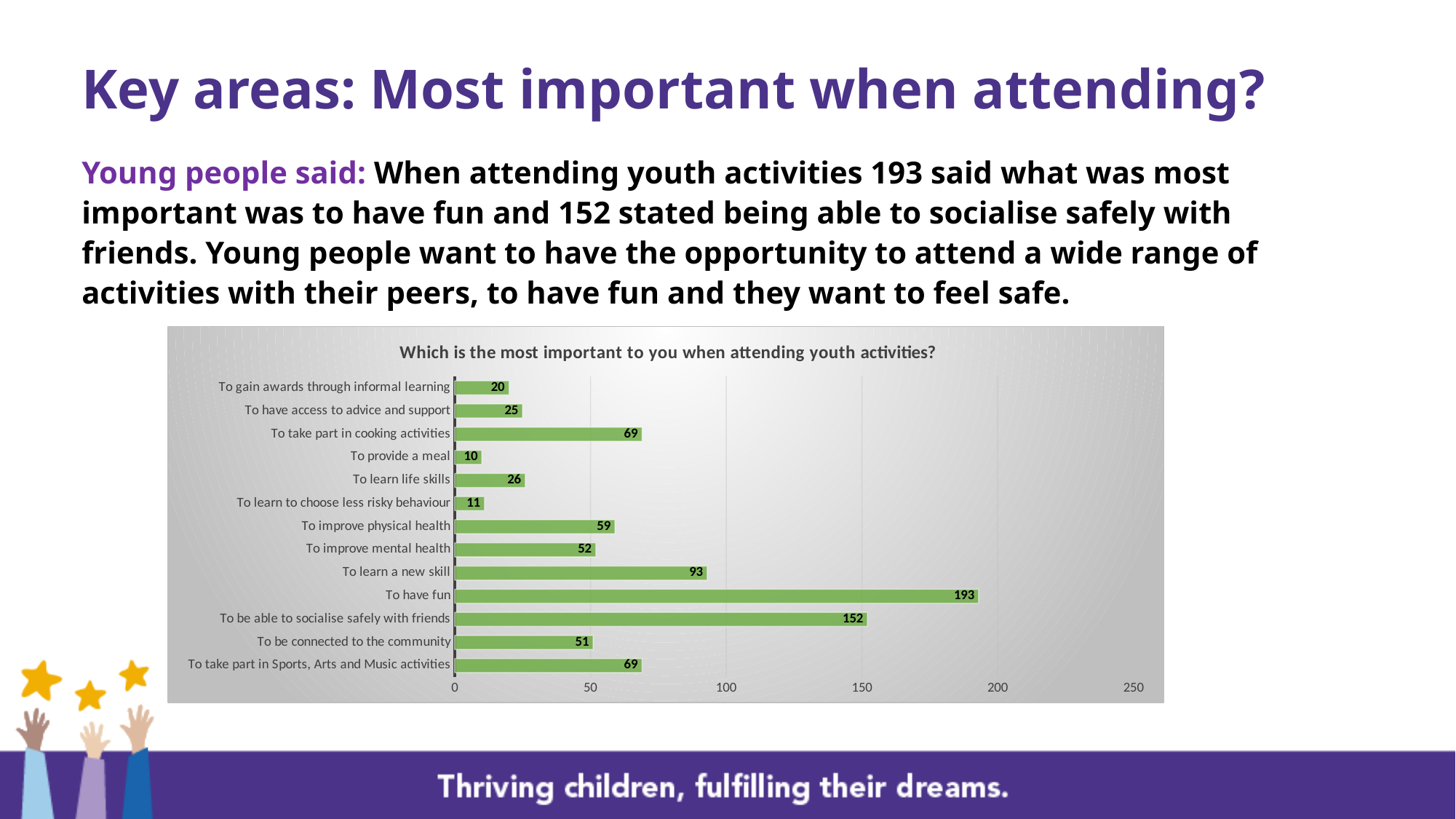
How many categories are shown in the chart? 13 Which category has the lowest value? To provide a meal What is the title of the chart? Which is the most important to you when attending youth activities? What value is shown for "To improve mental health"? 52 What value is shown for "To have fun"? 193 What is the difference between the values for "To take part in cooking activities" and "To be connected to the community"? 18 Which category has the highest value? To have fun Which is larger: the value for "To improve physical health" or "To improve mental health"? To improve physical health What kind of chart is shown on the slide? Bar chart What value is shown for "To learn a new skill"? 93 Is the value for "To be able to socialise safely with friends" greater or less than 100? greater What is the difference between the values for "To have fun" and "To be able to socialise safely with friends"? 41